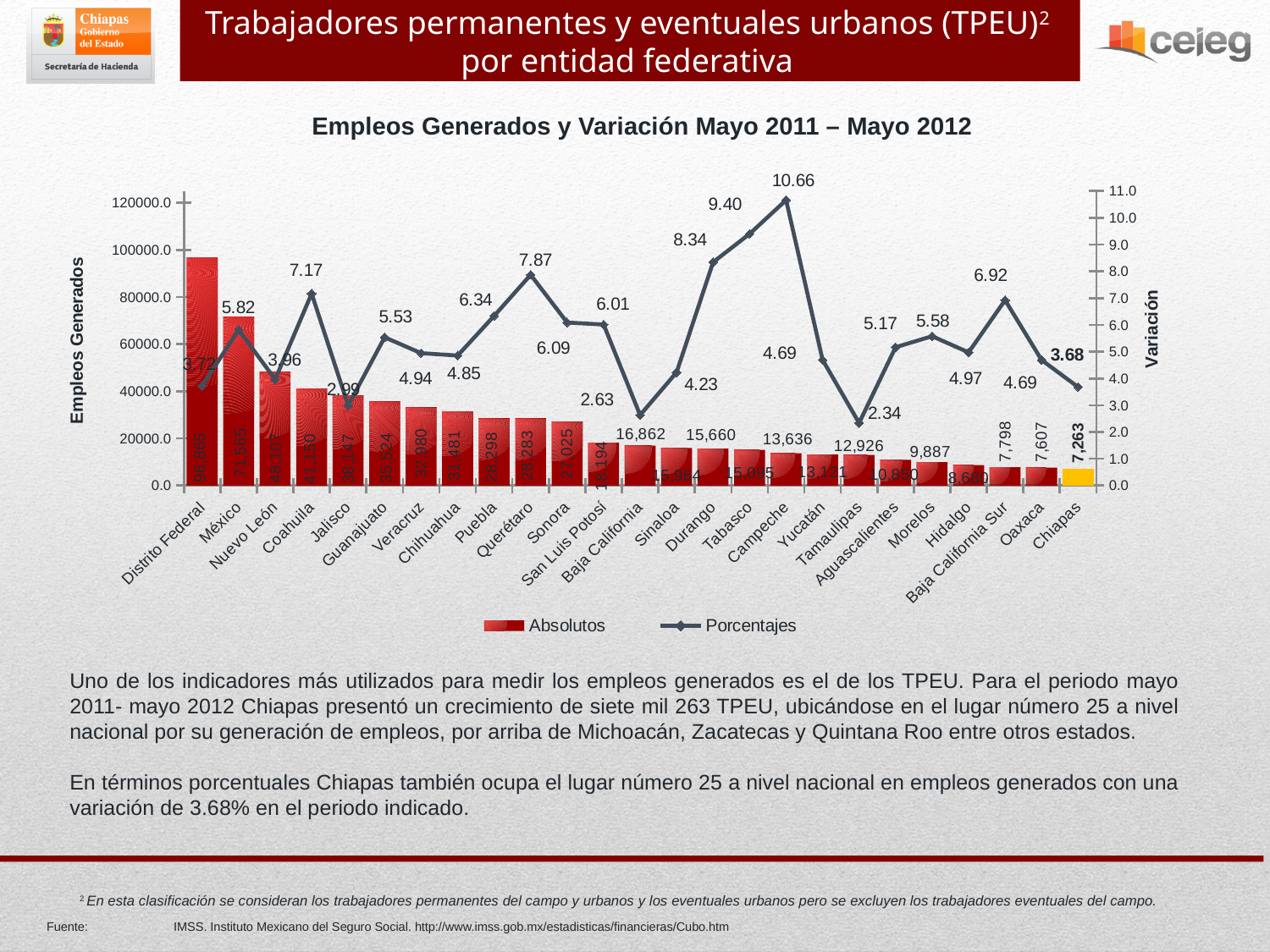
Which entidad has the highest Porcentajes value? Campeche Which has a higher Porcentajes value, Tabasco or Durango? Tabasco Which entidad has the lowest Porcentajes value? Tamaulipas How many entidades federativas are shown on the x axis? 25 What is the Porcentajes value for Chiapas? 3.68 What is the Absolutos value for Chiapas? 7,263 Which entidad has the highest Absolutos value? Distrito Federal What is the Porcentajes value for Campeche? 10.66 What is the difference between the Absolutos values for Baja California Sur and Oaxaca? 191 Is the Absolutos value for Distrito Federal greater or less than 80000.0? greater How many series does the legend list? 2 What kind of chart is shown on the slide? A combined bar and line chart